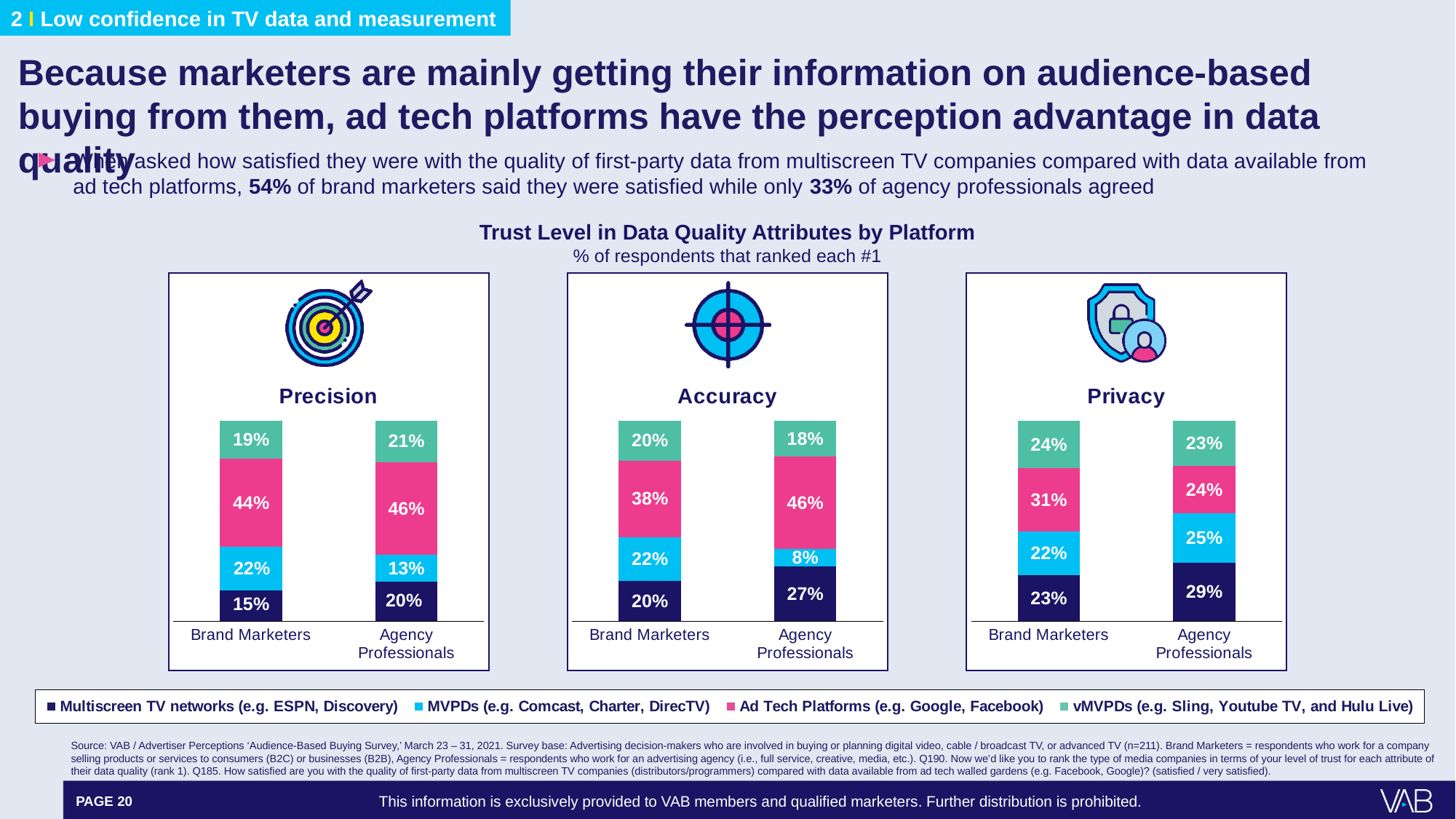
How many categories are shown on the x axis of the Accuracy chart? 2 What type of chart is used in the Privacy panel? Stacked bar chart In the Privacy chart, what is the value for Multiscreen TV networks among Agency Professionals? 29% In the Precision chart, which platform has the smallest share among Brand Marketers? Multiscreen TV networks In the Accuracy chart, which platform has the largest share among Agency Professionals? Ad Tech Platforms In the Accuracy chart, what is the value for MVPDs among Agency Professionals? 8% In the Precision chart, what percentage of Brand Marketers ranked Ad Tech Platforms #1? 44% What is the overall title above the three charts? Trust Level in Data Quality Attributes by Platform In the Privacy chart, which is larger for Brand Marketers: the Ad Tech Platforms value or the vMVPDs value? Ad Tech Platforms In the Precision chart, what is the total of the Agency Professionals stacked bar? 100% In the Accuracy chart, what is the difference between the Ad Tech Platforms values for Agency Professionals and Brand Marketers? 8 percentage points How many series does the legend list? 4